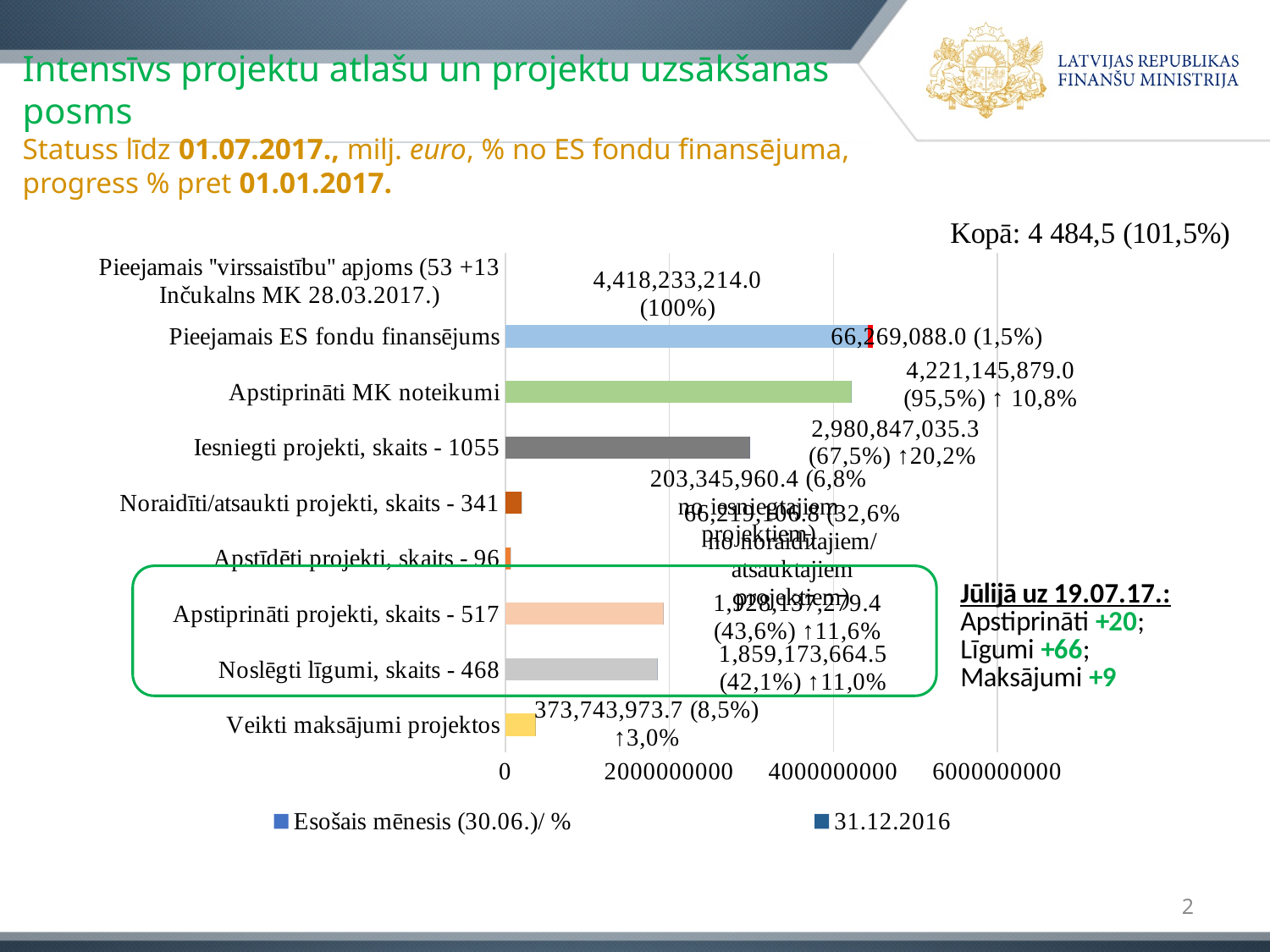
How many series does the chart legend list? 2 How many categories are listed on the vertical axis of the chart? 9 Is the value for "Iesniegti projekti, skaits - 1055" greater or less than 2000000000? greater What is the difference between the labelled values for "Apstiprināti projekti, skaits - 517" and "Noslēgti līgumi, skaits - 468"? 68,963,614.9 What percentage is shown in parentheses for "Iesniegti projekti, skaits - 1055"? 67,5% What value is labelled for "Apstiprināti MK noteikumi"? 4,221,145,879.0 What kind of chart is shown on the slide? bar chart What value is labelled for "Veikti maksājumi projektos"? 373,743,973.7 What are the two legend entries of the chart? Esošais mēnesis (30.06.)/ % and 31.12.2016 What progress percentage (with arrow) is shown for "Apstiprināti MK noteikumi"? ↑ 10,8% Which is larger, the value for "Apstiprināti projekti, skaits - 517" or for "Noslēgti līgumi, skaits - 468"? Apstiprināti projekti, skaits - 517 What value is labelled for "Noslēgti līgumi, skaits - 468"? 1,859,173,664.5